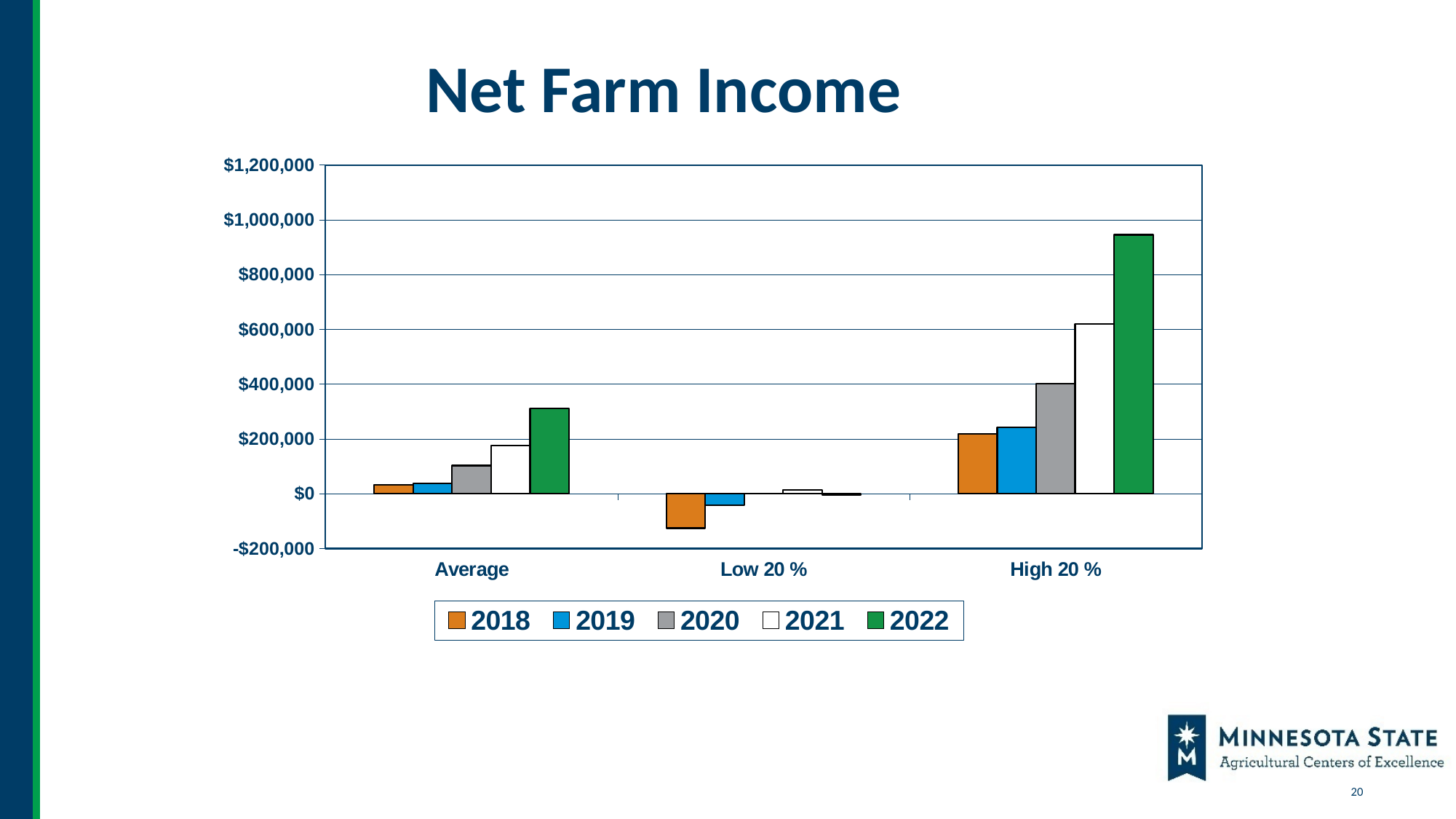
What type of chart is shown on the slide? Bar chart Which is larger: the 2022 value for Average or the 2018 value for High 20 %? 2022 value for Average How many categories are shown on the x axis? 3 Within the Low 20 % category, which year has the lowest net farm income? 2018 Within the High 20 % category, which is larger: the 2020 value or the 2021 value? 2021 How many series does the legend list? 5 Is the 2021 value for High 20 % greater or less than $400,000? greater Which category has the highest 2022 net farm income? High 20 % What is the title of the chart? Net Farm Income Is the 2022 value for High 20 % greater or less than $800,000? greater Is the 2018 value for Low 20 % greater or less than $0? less In the Average category, do the values rise or fall from 2018 to 2022? rise